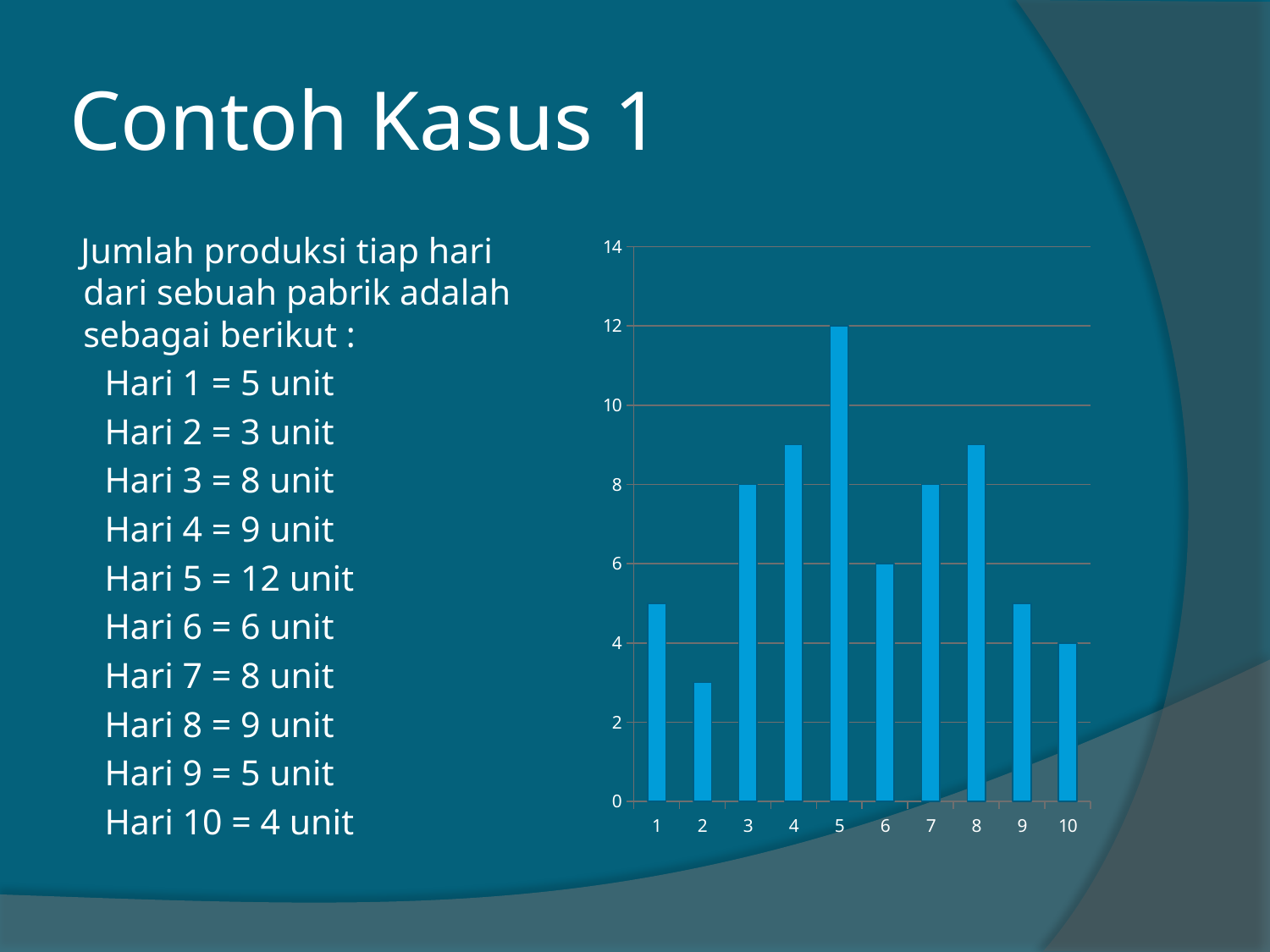
What is the difference between the values for day 5 and day 6? 6 Is the value for day 9 greater or less than 6? less What kind of chart is shown on the slide? bar chart What is the value of the bar for day 5? 12 Do the bar values rise or fall from day 8 to day 10? fall What is the value of the bar for day 6? 6 Is the value for day 4 greater or less than 8? greater What is the value of the bar for day 10? 4 How many categories (days) are plotted on the x axis of the chart? 10 Which day has the highest bar in the chart? 5 Which day has the larger value, day 3 or day 2? 3 Which day has the lowest bar in the chart? 2